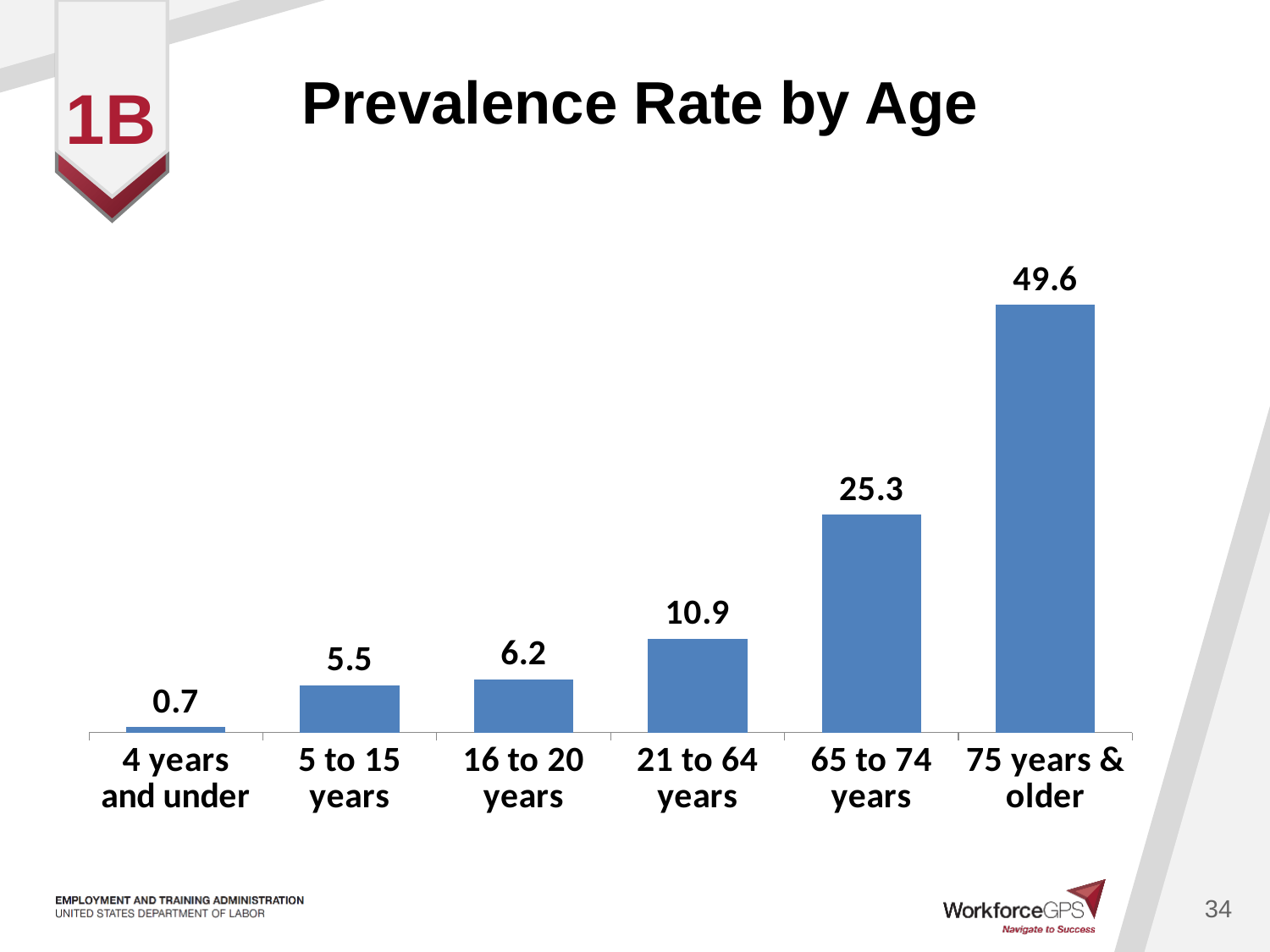
What is the prevalence rate for the 75 years & older age group? 49.6 What is the prevalence rate for the 4 years and under age group? 0.7 What is the difference between the prevalence rates for 16 to 20 years and 5 to 15 years? 0.7 What kind of chart is shown on the slide? Bar chart Which age group has the highest prevalence rate? 75 years & older Which age group has the lowest prevalence rate? 4 years and under How many age groups are shown in the chart? 6 What is the prevalence rate for the 21 to 64 years age group? 10.9 What is the title of the chart on the slide? Prevalence Rate by Age Do the prevalence rates rise or fall as age increases along the x axis? Rise What is the difference between the prevalence rates for 75 years & older and 65 to 74 years? 24.3 Which has a higher prevalence rate, 21 to 64 years or 65 to 74 years? 65 to 74 years